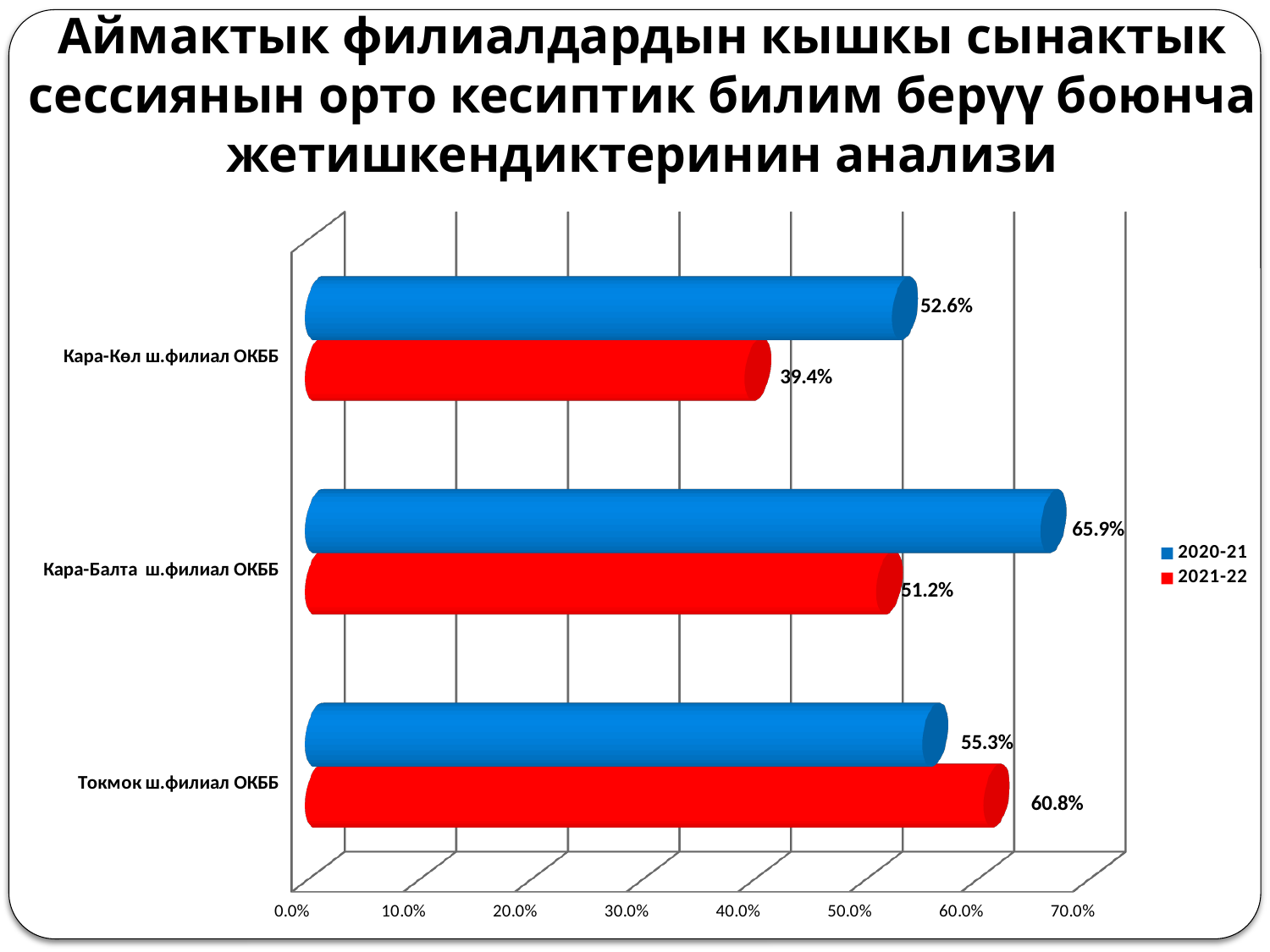
Which branch has the highest 2020-21 value? Кара-Балта ш.филиал ОКББ How many series does the legend list? 2 Is the 2021-22 value for Кара-Көл ш.филиал ОКББ greater or less than 40.0%? less Which colour represents the 2021-22 series? red What is the difference between the 2020-21 and 2021-22 values for Кара-Көл ш.филиал ОКББ? 13.2% What is the 2020-21 value for Кара-Көл ш.филиал ОКББ? 52.6% Which branch has the lowest 2021-22 value? Кара-Көл ш.филиал ОКББ What kind of chart is shown on the slide? bar chart What is the 2021-22 value for Кара-Балта ш.филиал ОКББ? 51.2% What is the 2021-22 value for Токмок ш.филиал ОКББ? 60.8% For Токмок ш.филиал ОКББ, which is larger: the 2020-21 value or the 2021-22 value? 2021-22 How many branches are shown on the chart? 3